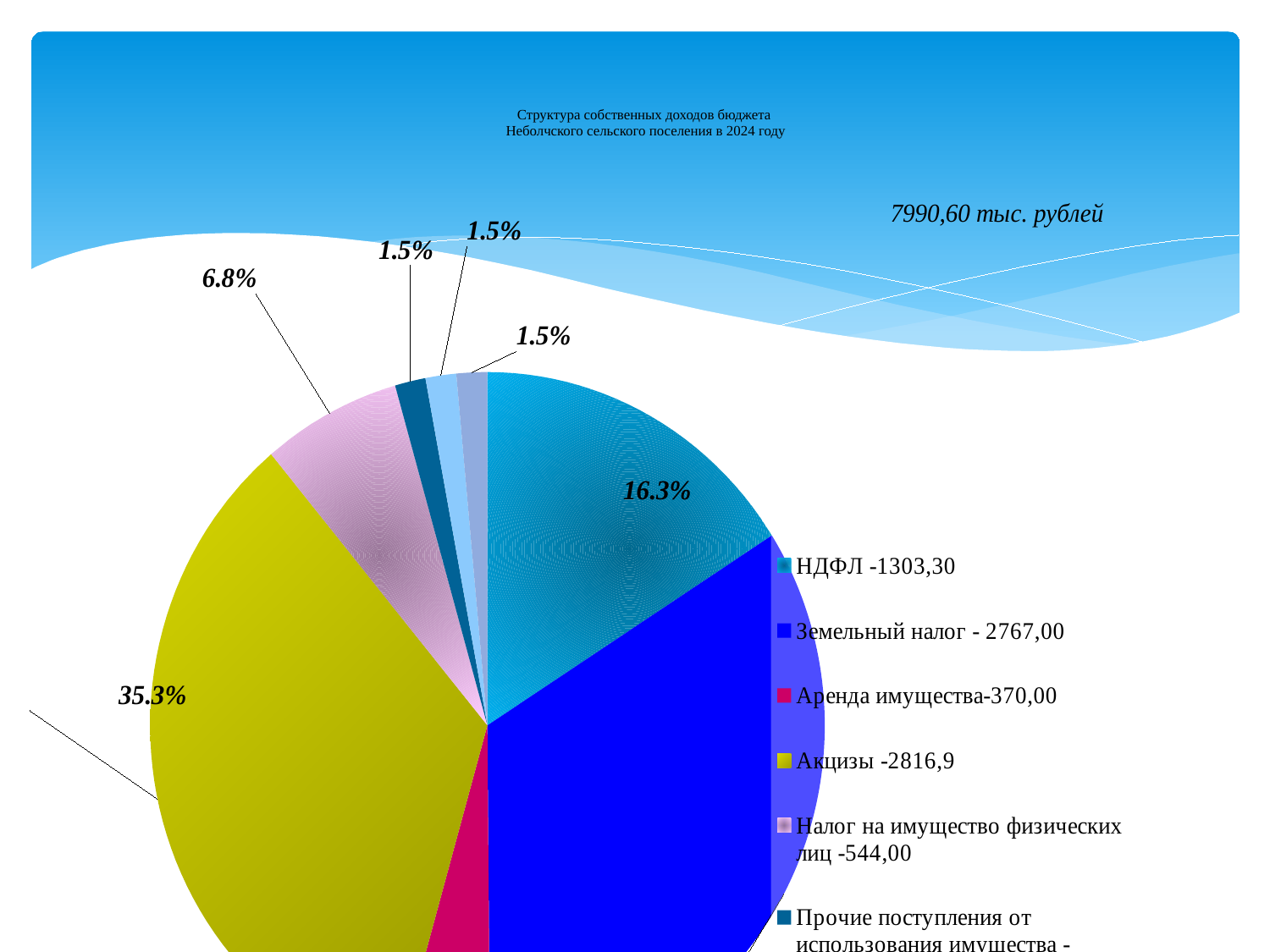
Which is larger according to the legend values, Акцизы or Земельный налог? Акцизы What is the difference between the legend values for Земельный налог and НДФЛ? 1463,70 What total amount in thousand rubles is shown on the slide? 7990,60 тыс. рублей What value does the legend give for НДФЛ? 1303,30 What value does the legend give for Налог на имущество физических лиц? 544,00 What share of the pie does Акцизы take? 35.3% What value does the legend give for Акцизы? 2816,9 What kind of chart is shown on the slide? pie chart What share of the pie does Налог на имущество физических лиц take? 6.8% What value does the legend give for Земельный налог? 2767,00 What value does the legend give for Аренда имущества? 370,00 What share of the pie does НДФЛ take? 16.3%